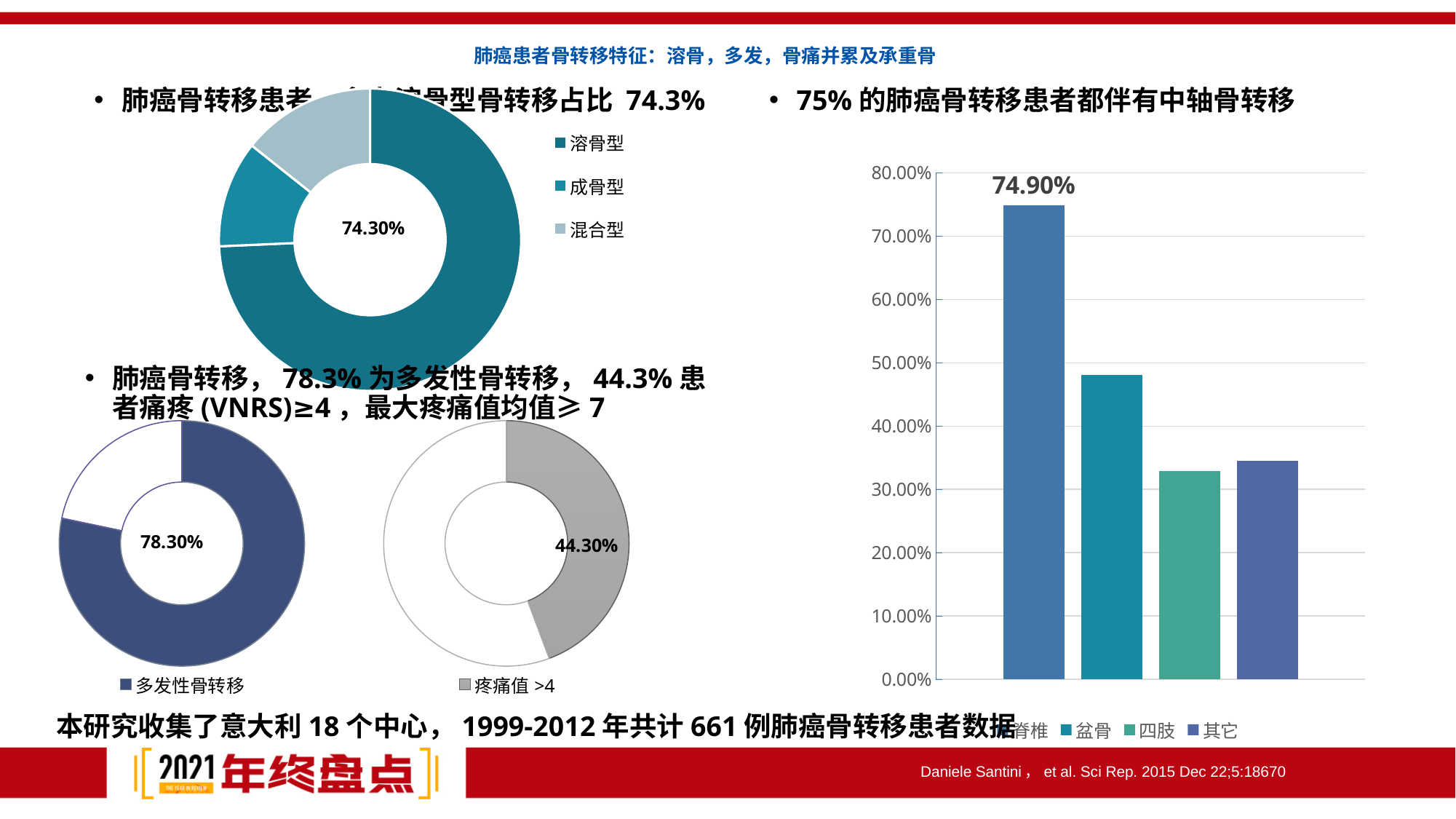
In the bar chart on the right, what is the value for 脊椎? 74.90% In the bottom-middle donut chart, what is the share for 疼痛值 >4? 44.30% In the bottom-left donut chart, what is the share for 多发性骨转移? 78.30% How many entries does the legend of the top-left donut chart list? 3 In the top-left donut chart, what is the share for 溶骨型? 74.30% In the bar chart on the right, is the value for 其它 greater or less than 40.00%? less In the bar chart on the right, is the value for 盆骨 greater or less than 50.00%? less In the bar chart on the right, which category has the highest value? 脊椎 In the bar chart on the right, which is larger, the value for 盆骨 or the value for 四肢? 盆骨 What kind of chart is the chart on the right side of the slide? bar chart In the bar chart on the right, is the value for 四肢 greater or less than 30.00%? greater How many bars are in the bar chart on the right? 4